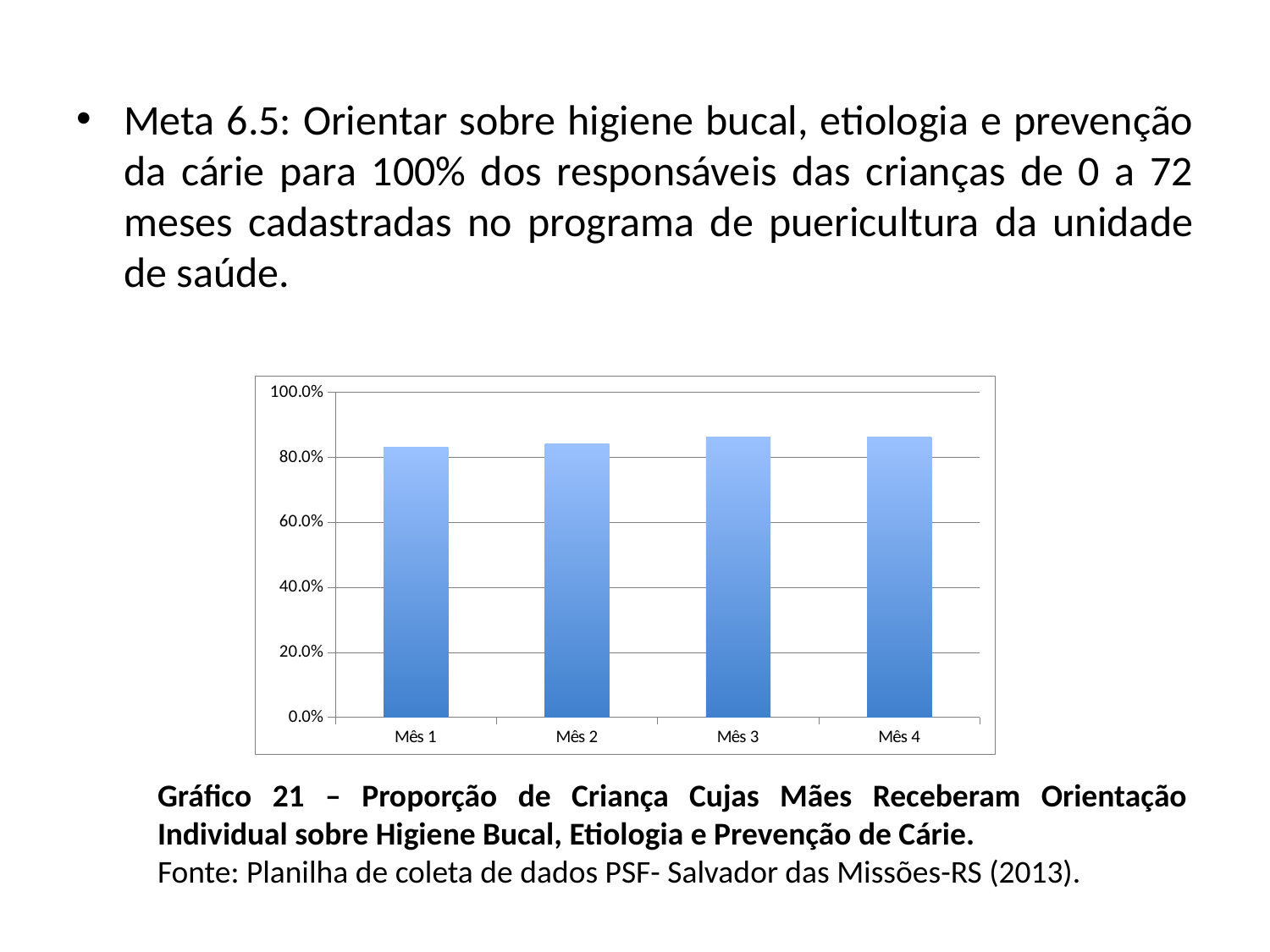
Is the value for Mês 3 greater or less than 100.0%? less What is the label of the first category on the x axis? Mês 1 Is the value for Mês 1 greater or less than 100.0%? less Is the value for Mês 2 greater or less than 80.0%? greater What kind of chart is shown on the slide? bar chart What is the highest tick value shown on the y axis of the chart? 100.0% How many categories (months) are shown on the x axis of the chart? 4